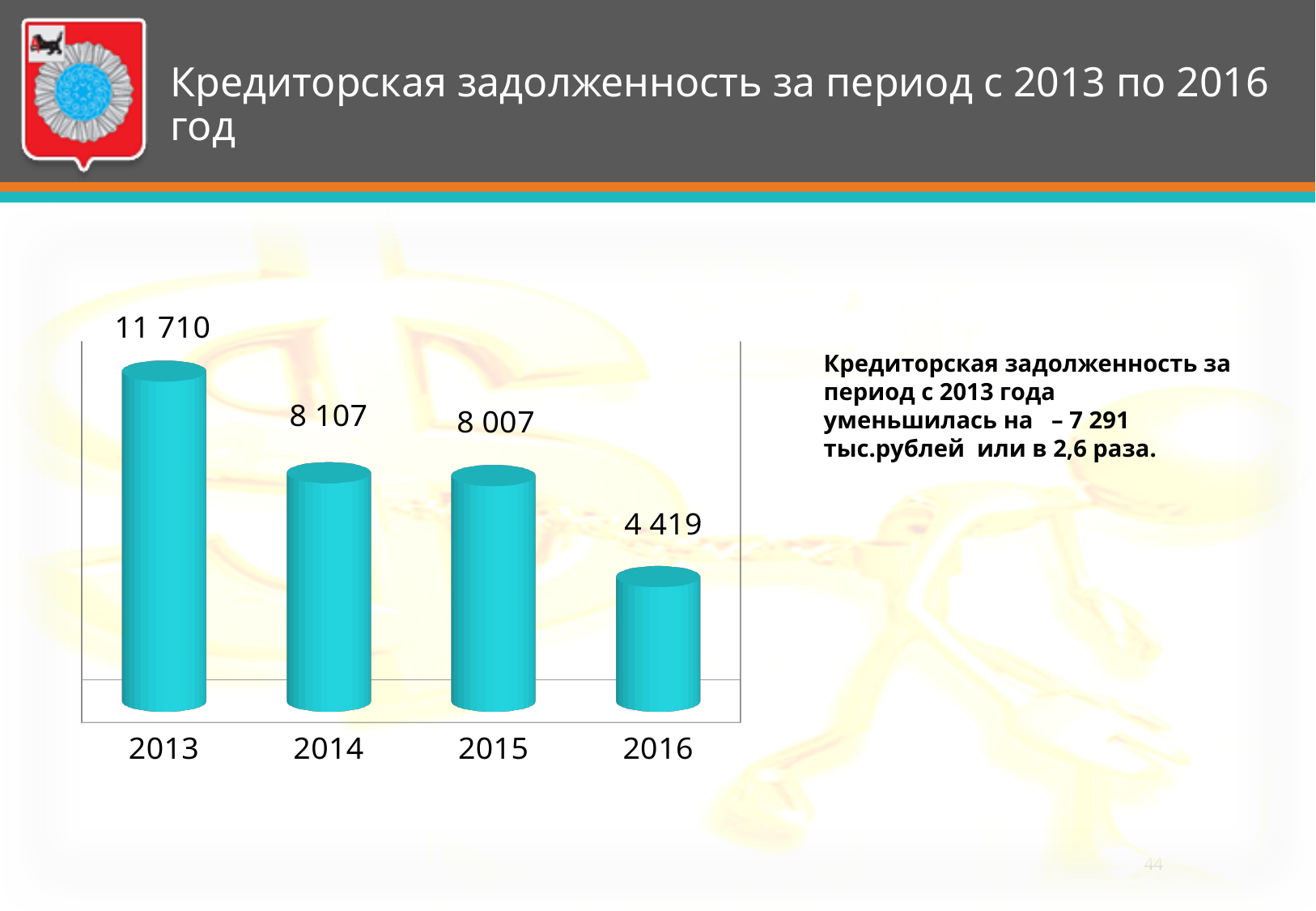
What is the value for 2014? 8 107 What is the value for 2016? 4 419 Which year has the highest value? 2013 What is the difference between the values for 2013 and 2016? 7 291 What is the value for 2015? 8 007 How many years are shown on the chart? 4 Which is larger, the value for 2013 or the value for 2014? 2013 What is the value for 2013? 11 710 What kind of chart is shown on the slide? bar chart Which year has the lowest value? 2016 What is the difference between the values for 2014 and 2015? 100 Do the values rise or fall from 2013 to 2016? fall